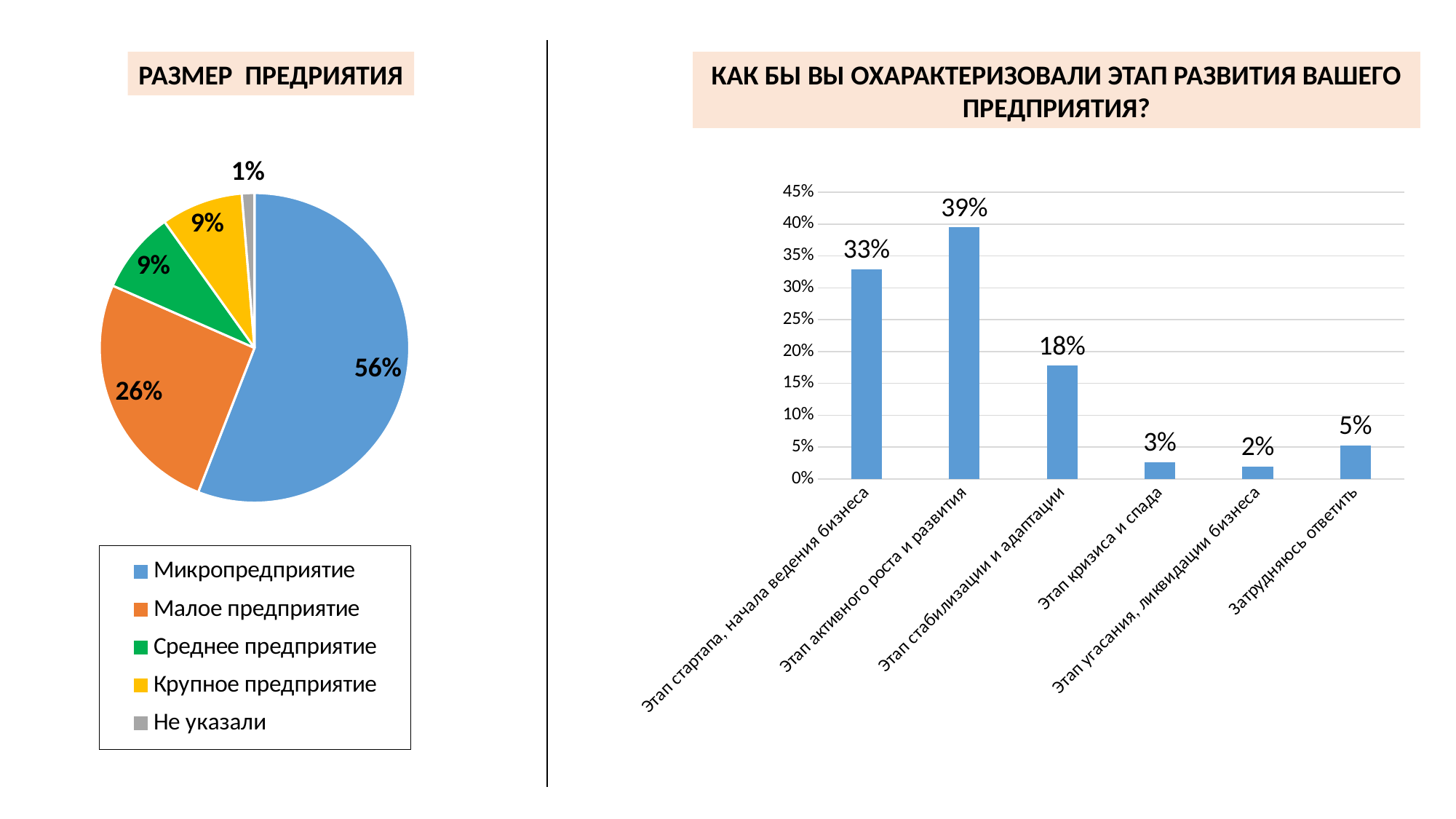
In the pie chart 'РАЗМЕР ПРЕДПРИЯТИЯ', which category has the smallest slice? Не указали In the bar chart on the right, how many categories are shown? 6 In the pie chart 'РАЗМЕР ПРЕДПРИЯТИЯ', what share is Микропредприятие? 56% In the bar chart on the right, which is larger: 'Этап стартапа, начала ведения бизнеса' or 'Этап активного роста и развития'? Этап активного роста и развития In the bar chart on the right, which category has the lowest value? Этап угасания, ликвидации бизнеса What type of chart is shown on the right side of the slide? Bar chart In the pie chart 'РАЗМЕР ПРЕДПРИЯТИЯ', what is the difference between Микропредприятие and Малое предприятие? 30% In the pie chart 'РАЗМЕР ПРЕДПРИЯТИЯ', which category has the largest slice? Микропредприятие In the bar chart on the right, what is the value for 'Этап активного роста и развития'? 39% In the pie chart 'РАЗМЕР ПРЕДПРИЯТИЯ', what share is Малое предприятие? 26% In the bar chart on the right, what is the value for 'Этап стабилизации и адаптации'? 18% In the pie chart 'РАЗМЕР ПРЕДПРИЯТИЯ', how many entries does the legend list? 5